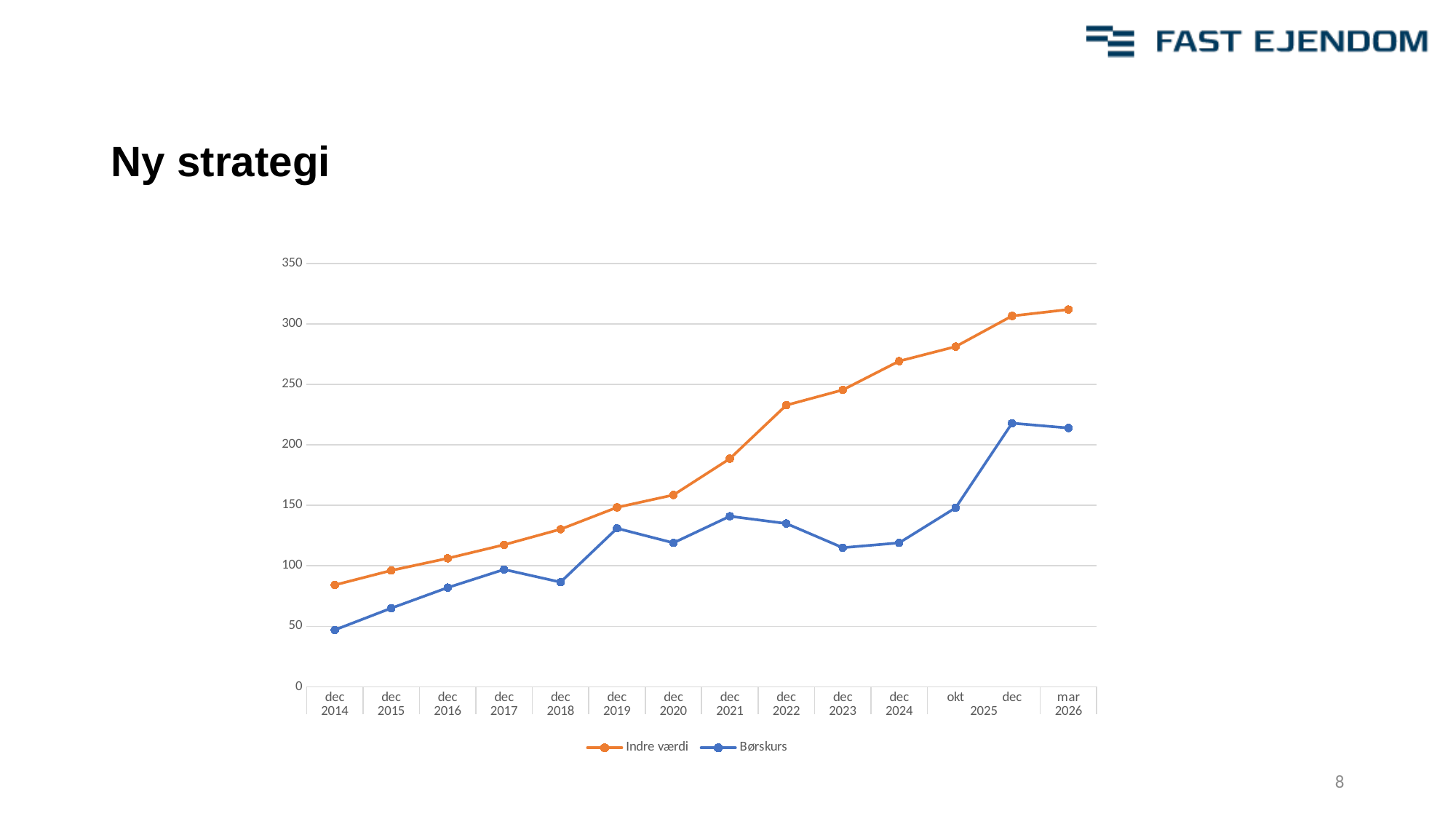
Is the value for Indre værdi at dec 2014 greater or less than 100? less Does the Indre værdi series generally rise or fall from dec 2014 to mar 2026? rise Is the value for Børskurs at dec 2025 greater or less than 200? greater At dec 2021, which series has the higher value, Indre værdi or Børskurs? Indre værdi What kind of chart is shown on the slide? line chart At which x-axis point does the Børskurs series reach its highest value? dec 2025 At which x-axis point does the Indre værdi series reach its highest value? mar 2026 At which x-axis point is the Børskurs series at its lowest value? dec 2014 How many data points are plotted along the x axis for each series? 14 Is the value for Indre værdi at mar 2026 greater or less than 300? greater How many series does the legend list? 2 What are the two series named in the legend? Indre værdi and Børskurs